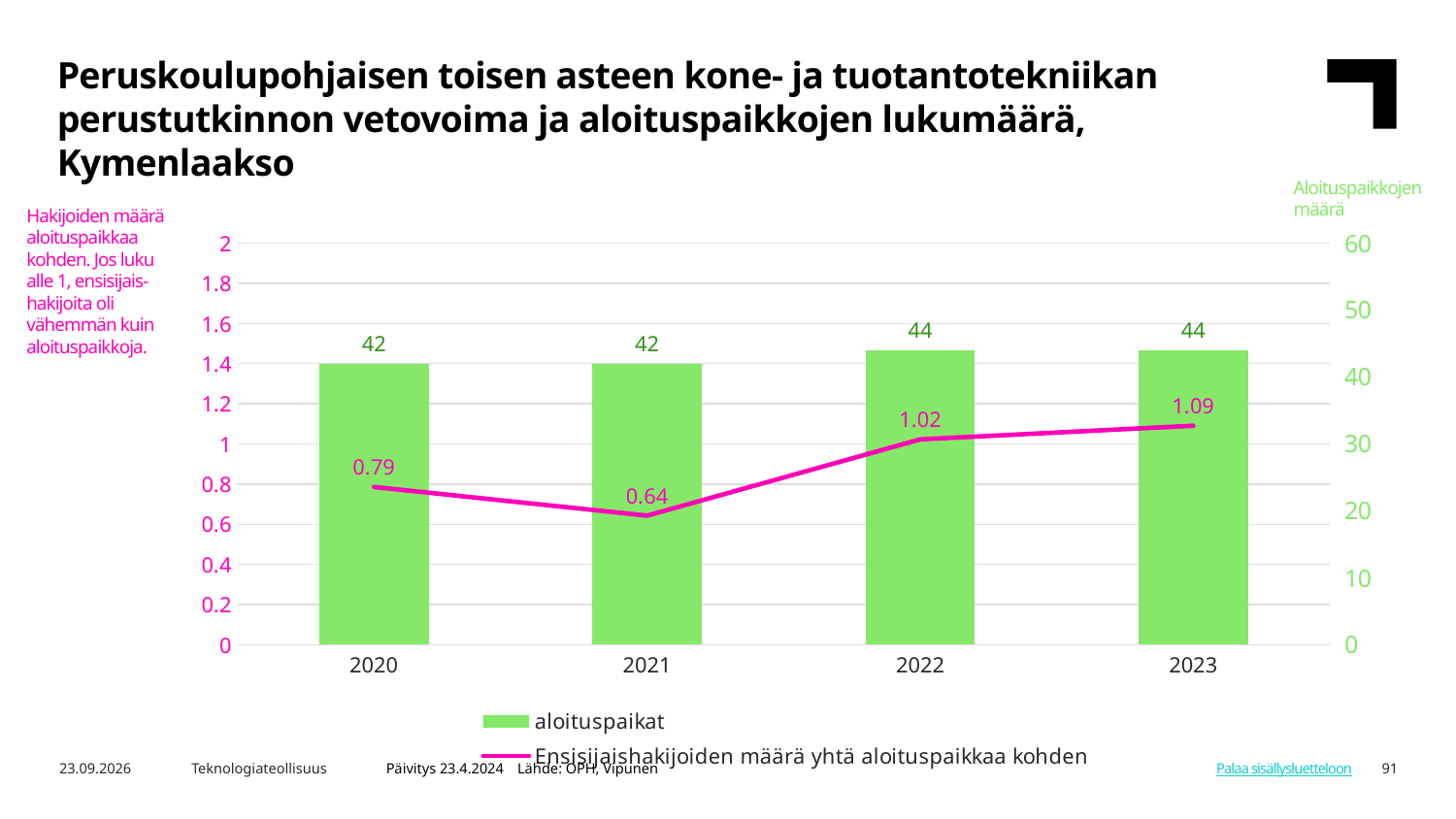
How many years are shown on the x axis? 4 What is the difference between the aloituspaikat values for 2023 and 2020? 2 What is the value of aloituspaikat for 2022? 44 In which year is Ensisijaishakijoiden määrä yhtä aloituspaikkaa kohden highest? 2023 Which year has a higher value of Ensisijaishakijoiden määrä yhtä aloituspaikkaa kohden, 2020 or 2022? 2022 What is the value of Ensisijaishakijoiden määrä yhtä aloituspaikkaa kohden for 2021? 0.64 How many series does the legend list? 2 Is the value of Ensisijaishakijoiden määrä yhtä aloituspaikkaa kohden for 2020 greater or less than 1? less In which year is Ensisijaishakijoiden määrä yhtä aloituspaikkaa kohden lowest? 2021 What is the value of Ensisijaishakijoiden määrä yhtä aloituspaikkaa kohden for 2023? 1.09 What colour are the aloituspaikat bars? Green What is the difference between the Ensisijaishakijoiden määrä yhtä aloituspaikkaa kohden values for 2022 and 2021? 0.38